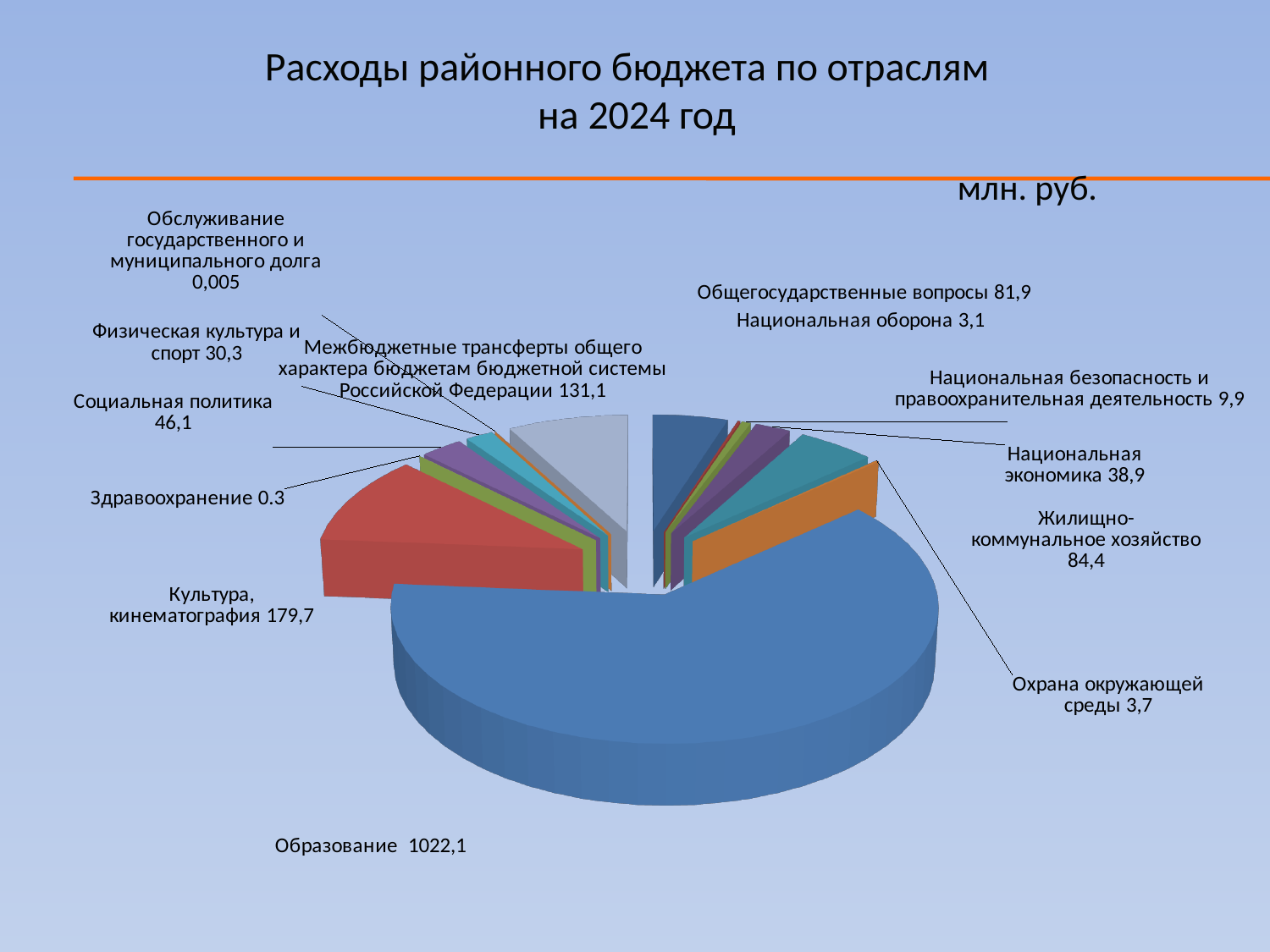
Which category has the largest value? Образование What is the value for Обслуживание государственного и муниципального долга? 0,005 What is the value for Образование? 1022,1 What kind of chart is shown on the slide? Pie chart What is the value for Жилищно-коммунальное хозяйство? 84,4 Which is larger: Общегосударственные вопросы or Национальная экономика? Общегосударственные вопросы What is the difference between Культура, кинематография and Межбюджетные трансферты общего характера бюджетам бюджетной системы Российской Федерации? 48,6 Which category has the smallest value? Обслуживание государственного и муниципального долга What is the difference between Социальная политика and Физическая культура и спорт? 15,8 What is the value for Культура, кинематография? 179,7 How many categories are shown in the pie chart? 13 In what units are the values on the chart given? млн. руб.